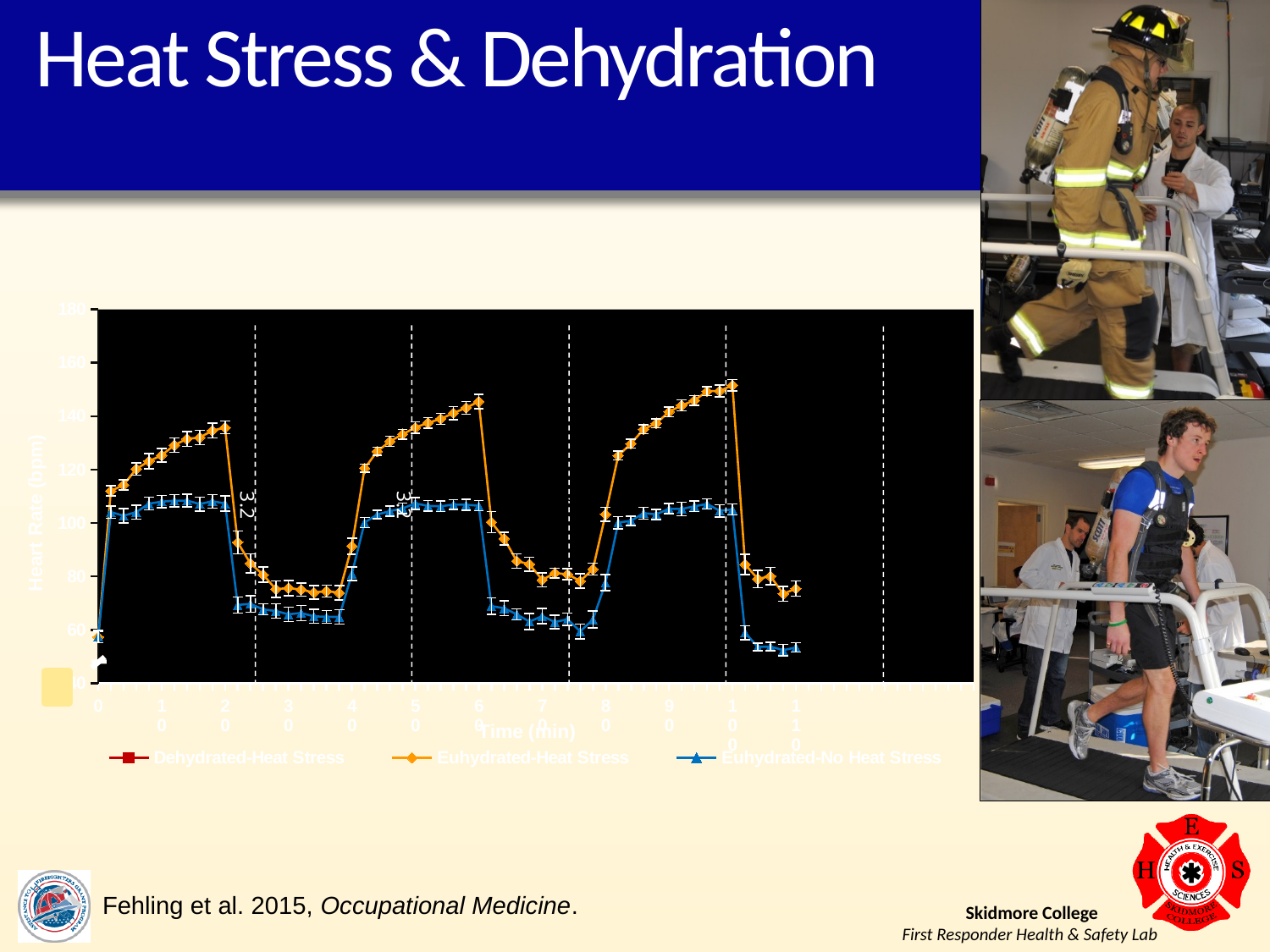
Do the peak heart rates of the Euhydrated-Heat Stress series rise or fall across the successive exercise bouts along the x axis? rise Is the value of the Euhydrated-Heat Stress series at around 30 minutes greater or less than 80? less How many series does the chart's legend list? 3 Is the value of the Euhydrated-Heat Stress series at around 60 minutes greater or less than 140? greater At around 20 minutes, which series has the higher heart rate: Euhydrated-Heat Stress or Euhydrated-No Heat Stress? Euhydrated-Heat Stress Is the value of the Euhydrated-No Heat Stress series at around 20 minutes greater or less than 120? less What is the label of the chart's vertical axis? Heart Rate (bpm) What are the three series named in the chart's legend? Dehydrated-Heat Stress, Euhydrated-Heat Stress, Euhydrated-No Heat Stress What kind of chart is shown on the slide? line chart